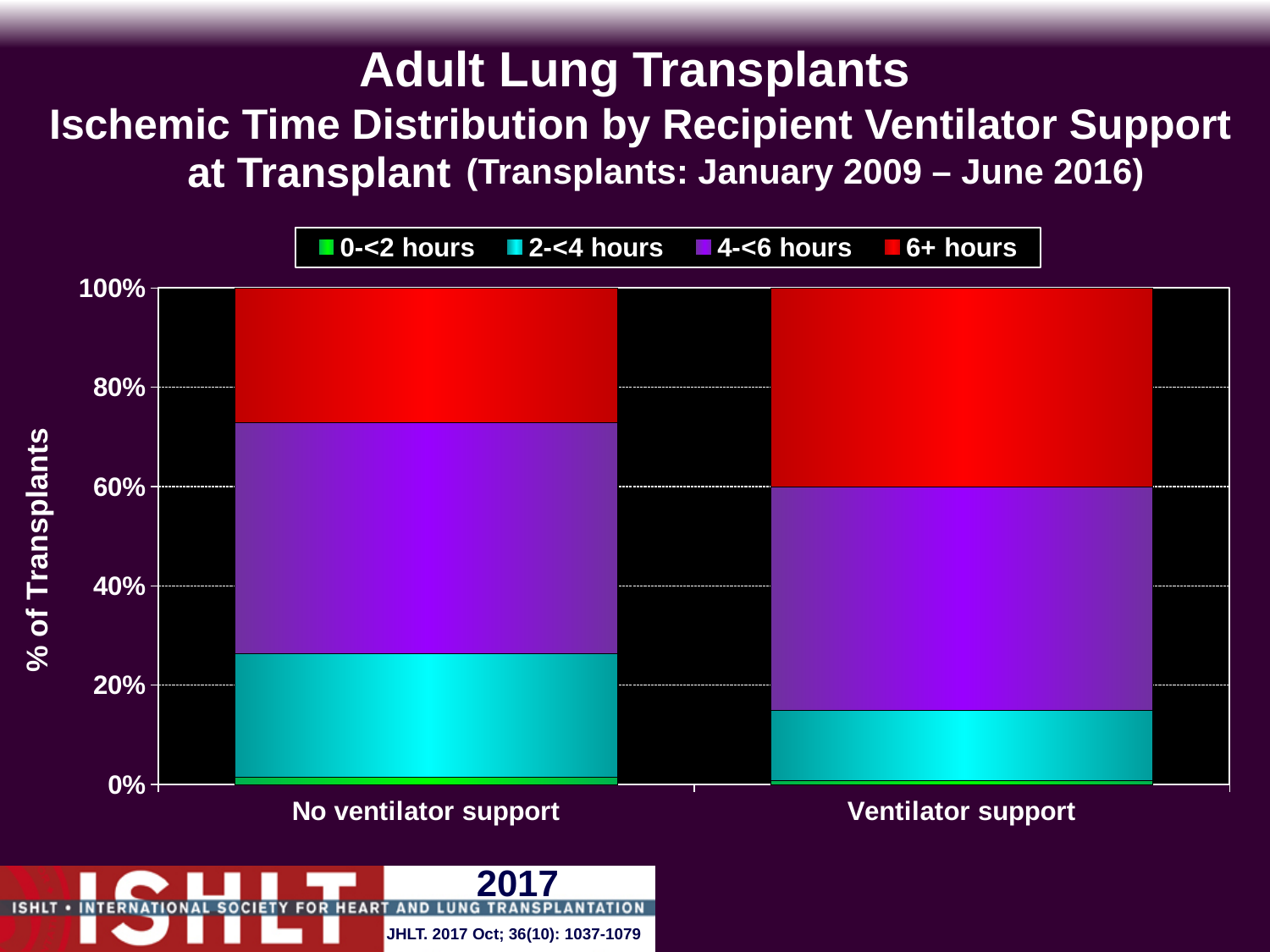
Which ischemic time group has the smallest share in the No ventilator support bar? 0-<2 hours How many categories are shown on the x axis? 2 Which colour represents the 6+ hours series in the legend? Red What kind of chart is shown on the slide? Stacked bar chart Is the share of 2-<4 hours for Ventilator support greater or less than 20%? less Which category has the larger share of 2-<4 hours, No ventilator support or Ventilator support? No ventilator support Is the share of 4-<6 hours for Ventilator support greater or less than 40%? greater Is the share of 6+ hours for No ventilator support greater or less than 20%? greater What is the label of the y axis? % of Transplants Which category has the larger share of 6+ hours, No ventilator support or Ventilator support? Ventilator support How many series does the legend list? 4